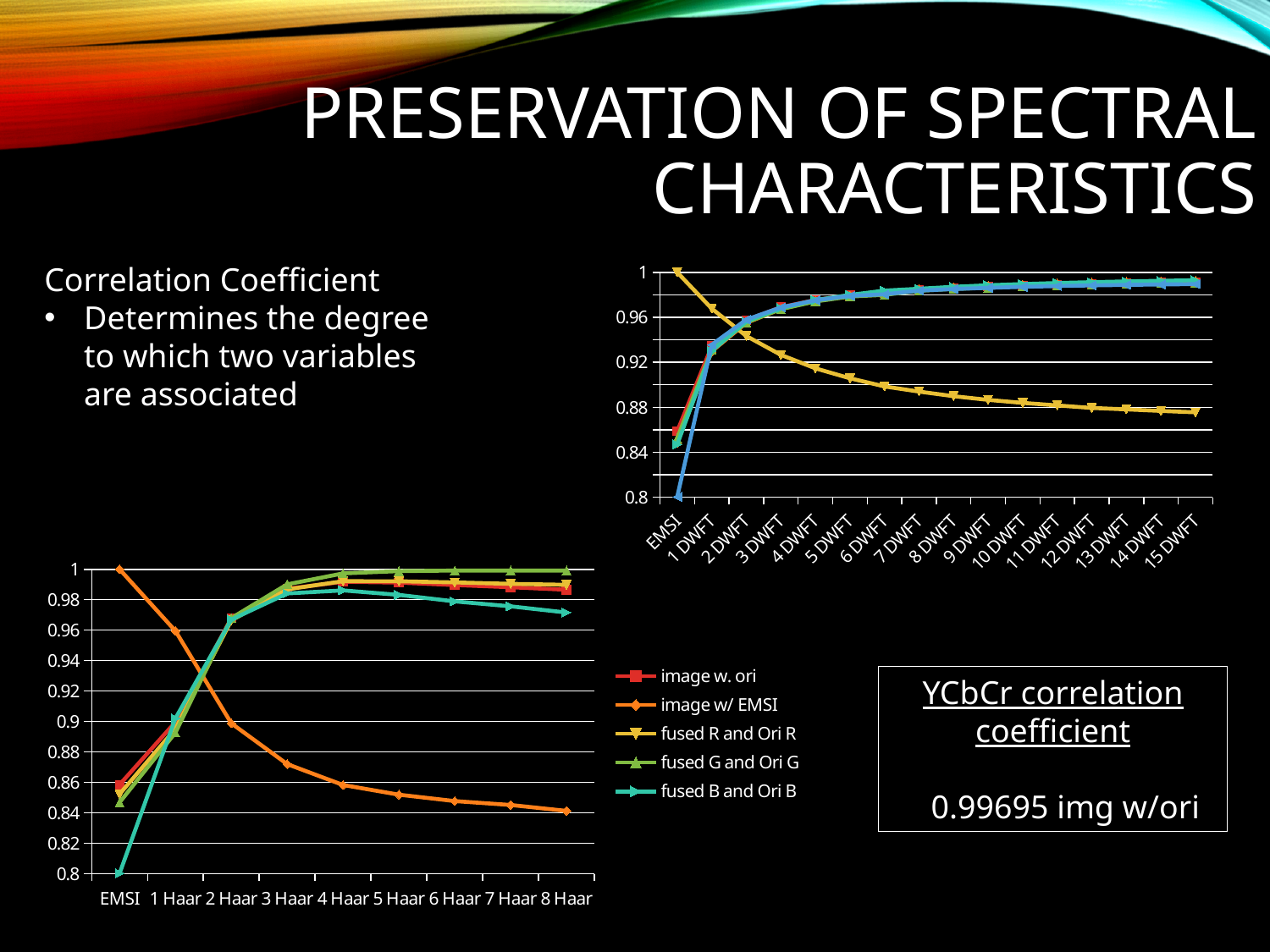
In the top-right chart, is the value at 10 DWFT of the line that starts at 1 at EMSI greater or less than 0.92? less In the bottom-left chart, what is the value of the 'image w/ EMSI' series at EMSI? 1 In the bottom-left chart, how many categories are on the x axis? 9 In the bottom-left chart, what is the value of the 'fused B and Ori B' series at EMSI? 0.8 In the bottom-left chart, does the 'image w/ EMSI' series rise or fall from EMSI to 8 Haar? fall How many series does the legend on the slide list? 5 What kind of chart is the chart in the bottom-left of the slide? line chart In the bottom-left chart, is the value of 'fused G and Ori G' at 8 Haar greater or less than 0.98? greater In the bottom-left chart, is the value of 'image w/ EMSI' at 8 Haar greater or less than 0.86? less What kind of chart is the chart in the top-right of the slide? line chart In the top-right chart, how many categories are on the x axis? 16 In the top-right chart, does the line that starts at 1 at EMSI rise or fall from EMSI to 15 DWFT? fall